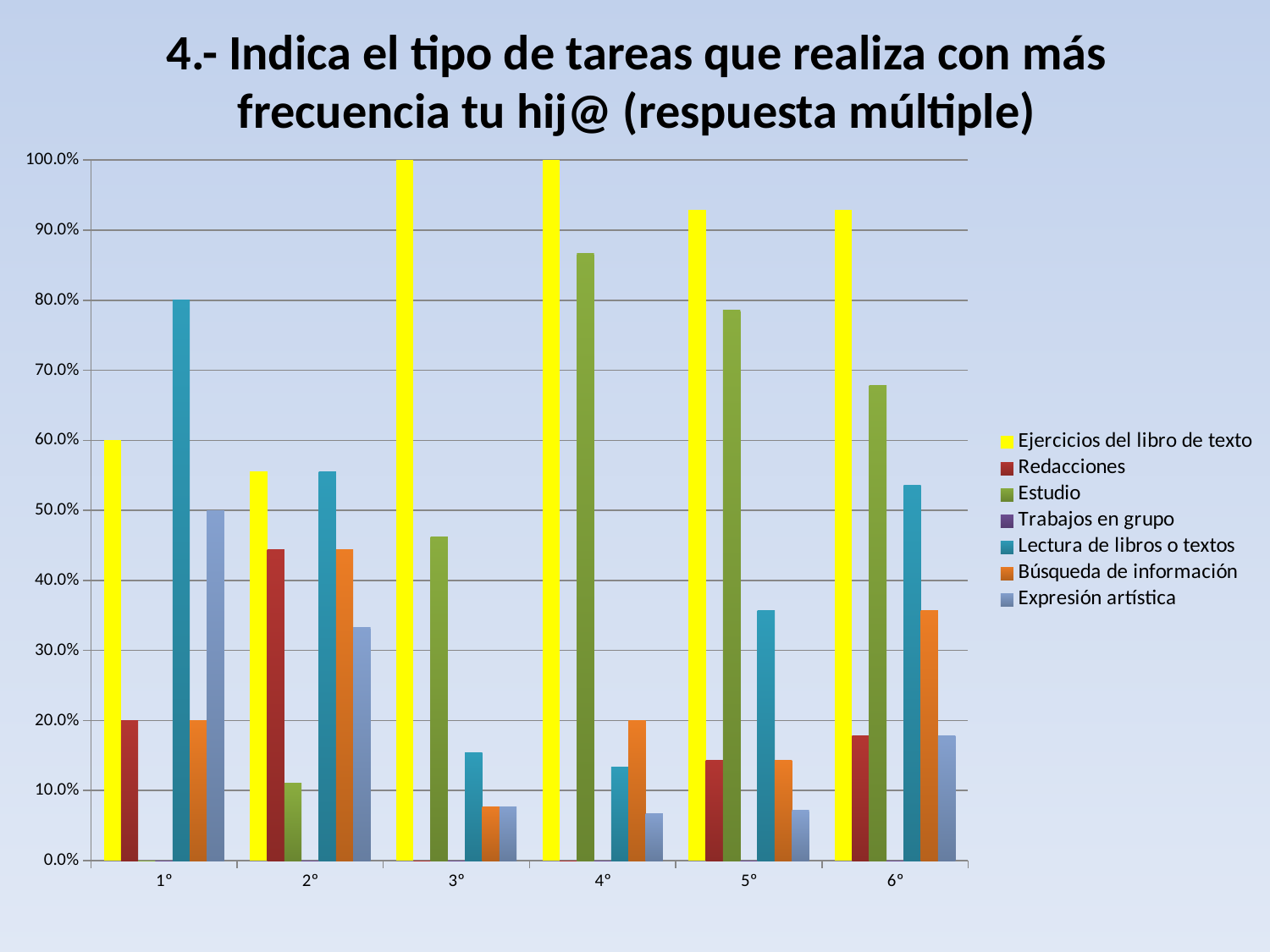
Which series is shown in yellow in the legend? Ejercicios del libro de texto How many series does the legend list? 7 Which is larger, Estudio for 4° or Estudio for 5°? Estudio for 4° Is the value of Estudio for 6° greater or less than 70.0%? less Which category has the lowest value for Estudio? 1° How many categories are shown on the x axis? 6 Which category has the highest value for Estudio? 4° What is the value of Lectura de libros o textos for 1°? 80.0% What is the value of Ejercicios del libro de texto for 3°? 100.0% What type of chart is shown on the slide? bar chart Is the value of Estudio for 4° greater or less than 80.0%? greater What is the value of Ejercicios del libro de texto for 1°? 60.0%